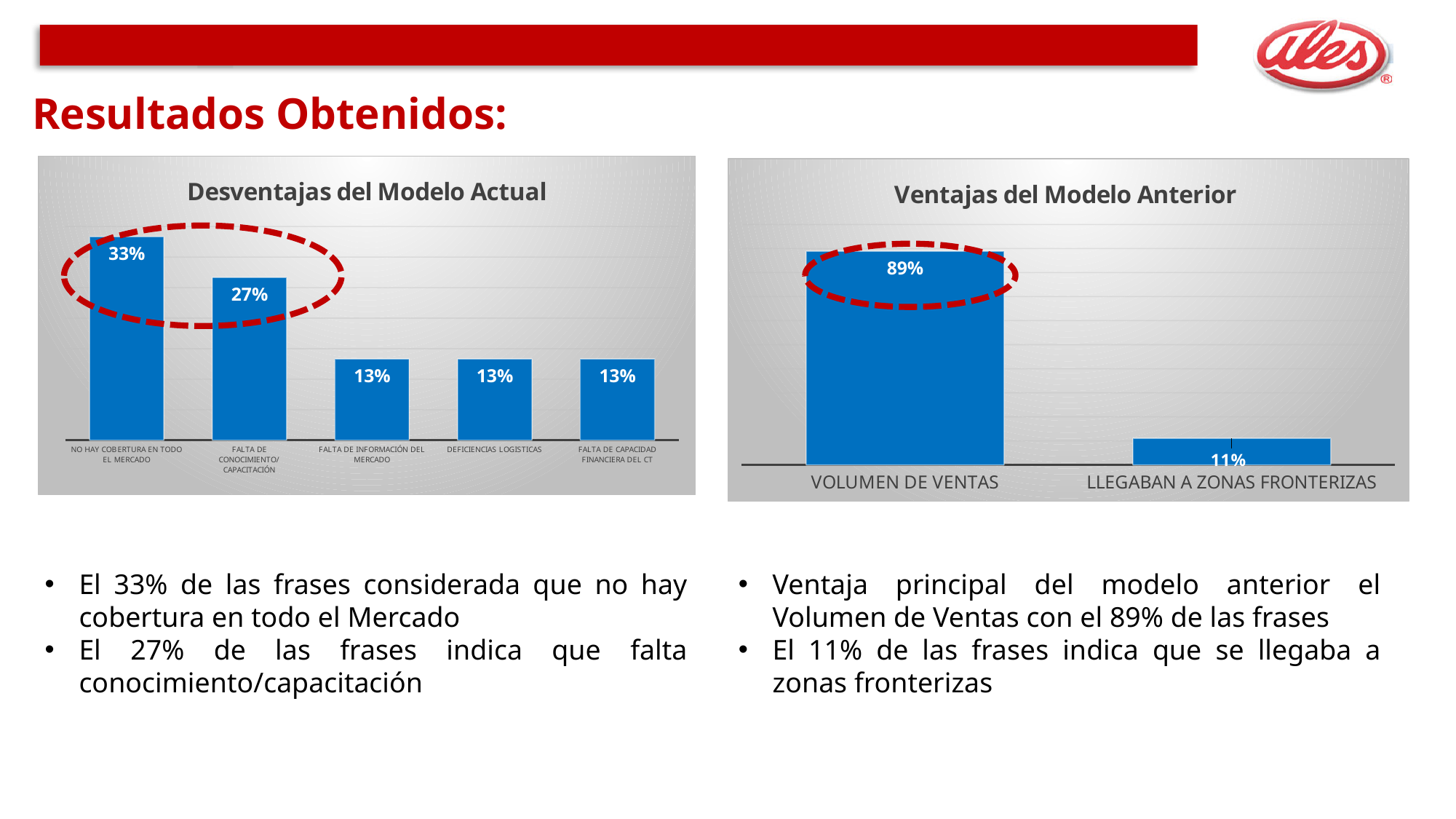
In the 'Ventajas del Modelo Anterior' chart, what is the difference between 'Volumen de ventas' and 'Llegaban a zonas fronterizas'? 78% In the 'Desventajas del Modelo Actual' chart, what is the value for 'No hay cobertura en todo el mercado'? 33% In the 'Desventajas del Modelo Actual' chart, how many categories have a value of 13%? 3 In the 'Desventajas del Modelo Actual' chart, which category has the highest value? No hay cobertura en todo el mercado In the 'Desventajas del Modelo Actual' chart, what is the difference between 'No hay cobertura en todo el mercado' and 'Falta de conocimiento/capacitación'? 6% In the 'Ventajas del Modelo Anterior' chart, what is the value for 'Volumen de ventas'? 89% In the 'Desventajas del Modelo Actual' chart, what is the value for 'Deficiencias logisticas'? 13% In the 'Ventajas del Modelo Anterior' chart, what is the value for 'Llegaban a zonas fronterizas'? 11% What type of chart is the 'Ventajas del Modelo Anterior' chart? Bar chart In the 'Ventajas del Modelo Anterior' chart, which category has the lowest value? Llegaban a zonas fronterizas In the 'Desventajas del Modelo Actual' chart, what is the value for 'Falta de conocimiento/capacitación'? 27% In the 'Desventajas del Modelo Actual' chart, how many categories are shown? 5